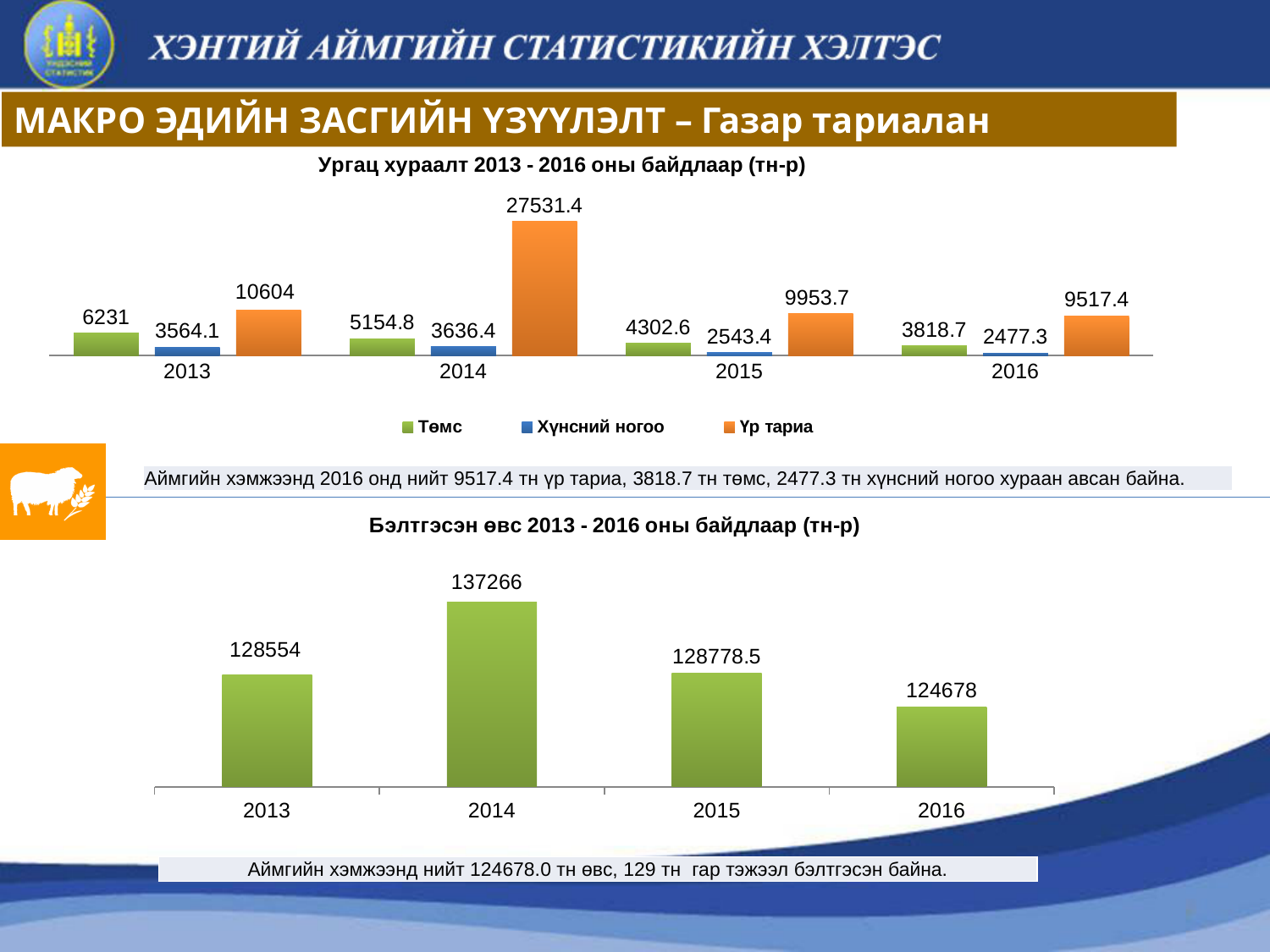
In the chart titled "Бэлтгэсэн өвс 2013 - 2016 оны байдлаар (тн-р)", what is the value for 2014? 137266 What kind of chart is the chart titled "Бэлтгэсэн өвс 2013 - 2016 оны байдлаар (тн-р)"? Bar chart In the chart titled "Бэлтгэсэн өвс 2013 - 2016 оны байдлаар (тн-р)", what is the difference between the values for 2014 and 2013? 8712 In the chart titled "Бэлтгэсэн өвс 2013 - 2016 оны байдлаар (тн-р)", which year has the lowest value? 2016 In the chart titled "Бэлтгэсэн өвс 2013 - 2016 оны байдлаар (тн-р)", how many years are shown on the x axis? 4 In the chart titled "Ургац хураалт 2013 - 2016 оны байдлаар (тн-р)", what is the value for Үр тариа in 2014? 27531.4 In the chart titled "Ургац хураалт 2013 - 2016 оны байдлаар (тн-р)", which year has the lowest value for Хүнсний ногоо? 2016 In the chart titled "Ургац хураалт 2013 - 2016 оны байдлаар (тн-р)", what is the value for Хүнсний ногоо in 2016? 2477.3 In the chart titled "Ургац хураалт 2013 - 2016 оны байдлаар (тн-р)", how many series does the legend list? 3 In the chart titled "Ургац хураалт 2013 - 2016 оны байдлаар (тн-р)", what is the difference between the Үр тариа values for 2015 and 2016? 436.3 In the chart titled "Ургац хураалт 2013 - 2016 оны байдлаар (тн-р)", which colour represents Үр тариа? Orange In the chart titled "Ургац хураалт 2013 - 2016 оны байдлаар (тн-р)", which year has the highest value for Төмс? 2013